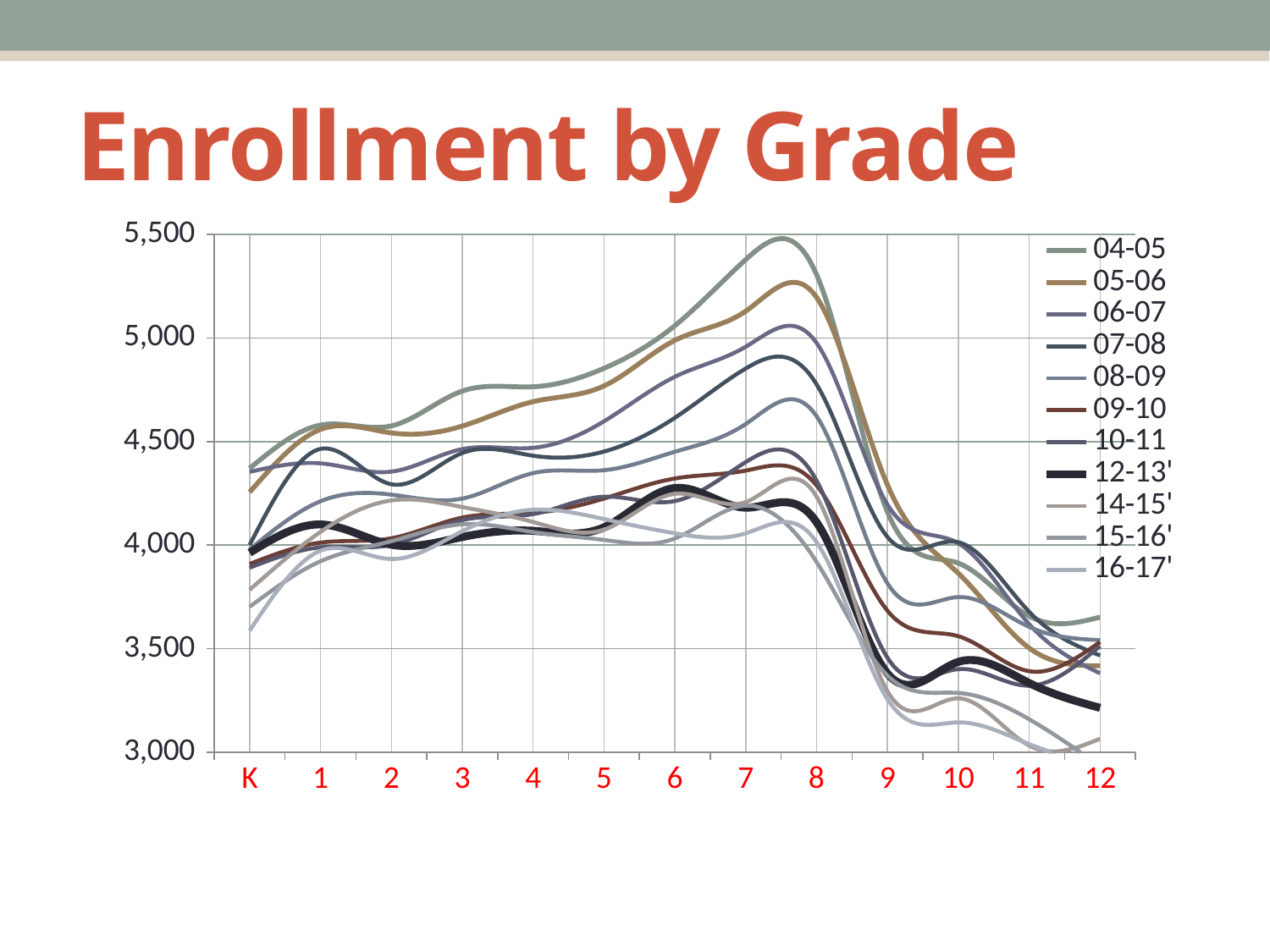
What kind of chart is shown on the slide? Line chart Is the value for 16-17' at grade K greater or less than 4,000? less How many series does the legend list? 11 Which series reaches the highest enrollment value on the chart? 04-05 What is the title of the chart? Enrollment by Grade Is the value for 04-05 at grade 8 greater or less than 5,000? greater Does the 04-05 line rise or fall from grade 8 to grade 12? Fall At grade 8, which is larger: the value for 04-05 or the value for 16-17'? 04-05 Is the value for 05-06 at grade 8 greater or less than 5,000? greater Which series has the lowest value at grade K? 16-17' How many grade categories are shown on the x axis? 13